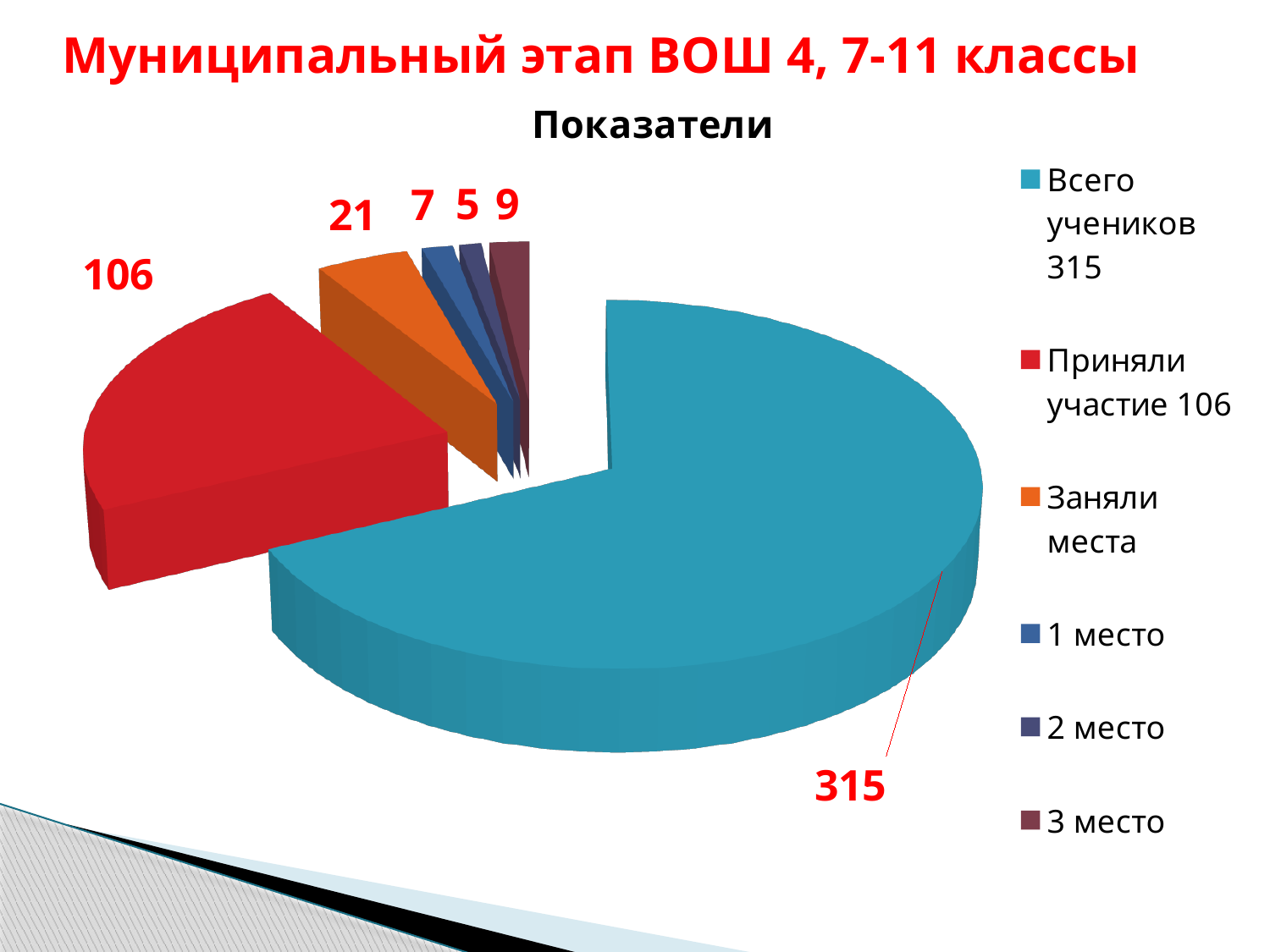
What is the value of the "Заняли места" slice? 21 What is the value of the slice labelled "Всего учеников 315"? 315 What kind of chart is shown on the slide? pie chart What is the value of the "1 место" slice? 7 What is the chart's title? Показатели Which slice is the largest in the pie chart? Всего учеников 315 How many entries does the legend list? 6 Which slice is the smallest in the pie chart? 2 место What is the value of the "2 место" slice? 5 How many slices does the pie chart have? 6 What is the value of the "3 место" slice? 9 What is the value of the slice labelled "Приняли участие 106"? 106